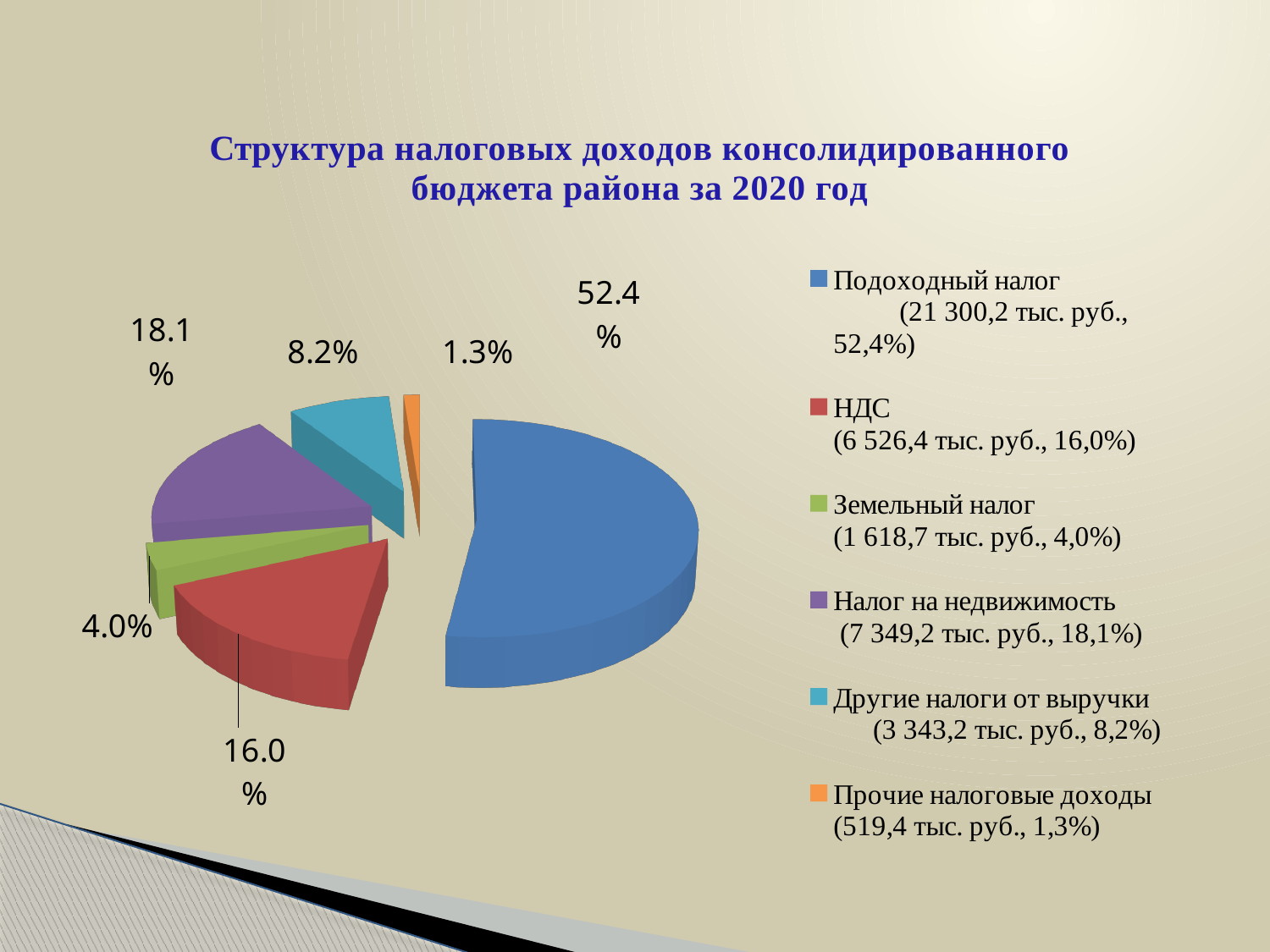
What share of the pie does НДС represent? 16.0% Which category has the largest slice of the pie? Подоходный налог What is the title of the chart? Структура налоговых доходов консолидированного бюджета района за 2020 год How many slices does the pie chart have? 6 What share of the pie does Подоходный налог represent? 52.4% What share of the pie does Другие налоги от выручки represent? 8.2% According to the legend, what amount in thousand rubles corresponds to Земельный налог? 1 618,7 тыс. руб. What is the difference in percentage points between the shares of Налог на недвижимость and НДС? 2.1 percentage points What colour is the slice for Подоходный налог? Blue Which category has the smallest slice of the pie? Прочие налоговые доходы What kind of chart is shown on the slide? Pie chart Which slice is larger: Налог на недвижимость or Другие налоги от выручки? Налог на недвижимость